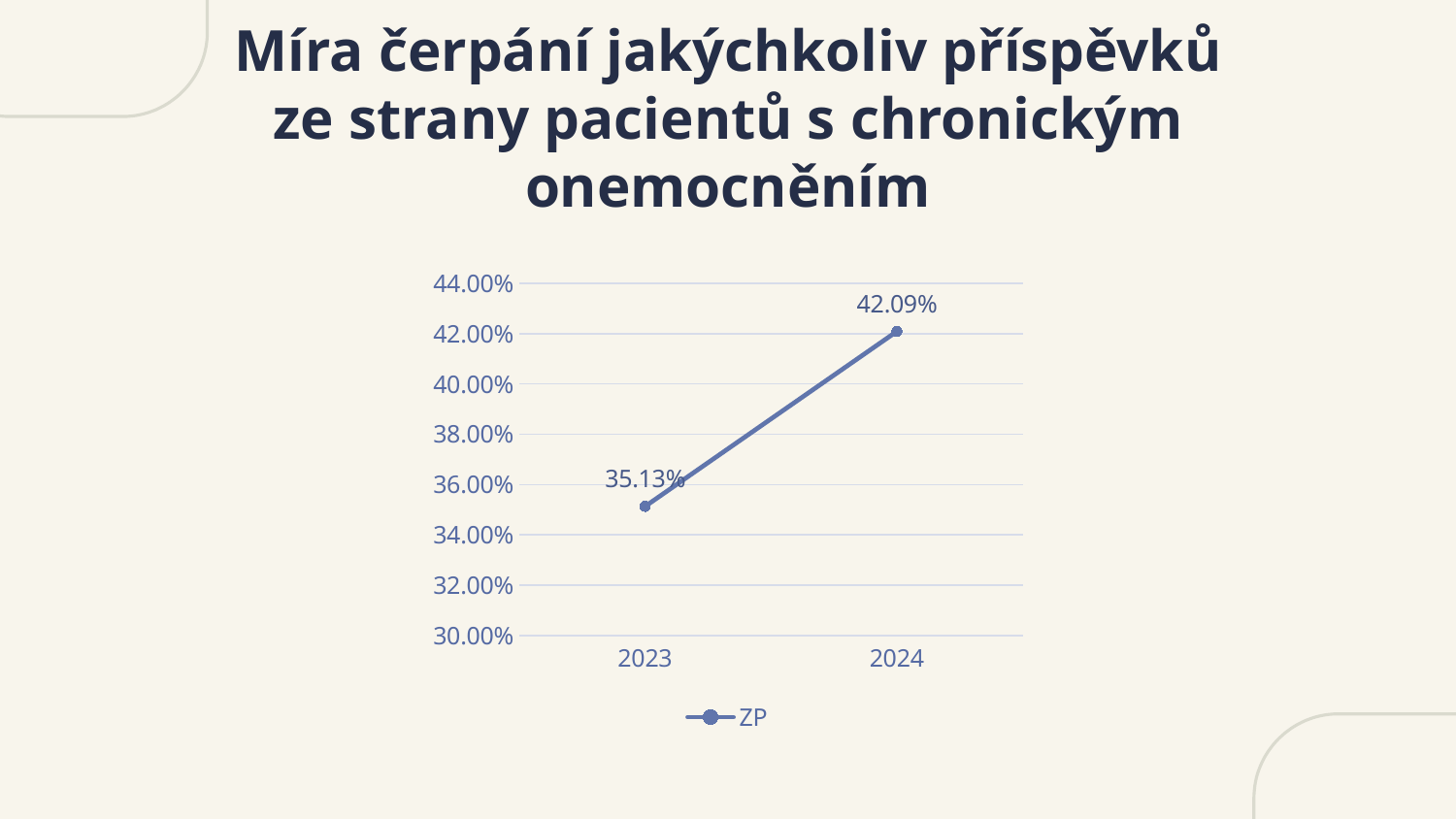
How many data points are plotted on the chart? 2 Which year has the highest value? 2024 Which is larger, the value for 2023 or the value for 2024? 2024 Is the value for 2024 greater or less than 42.00%? greater How many series does the legend list? 1 What kind of chart is shown on the slide? line chart What is the difference between the values for 2024 and 2023? 6.96% What is the value for 2023? 35.13% Which year has the lowest value? 2023 Does the value rise or fall from 2023 to 2024? rise What is the value for 2024? 42.09% Is the value for 2023 greater or less than 36.00%? less